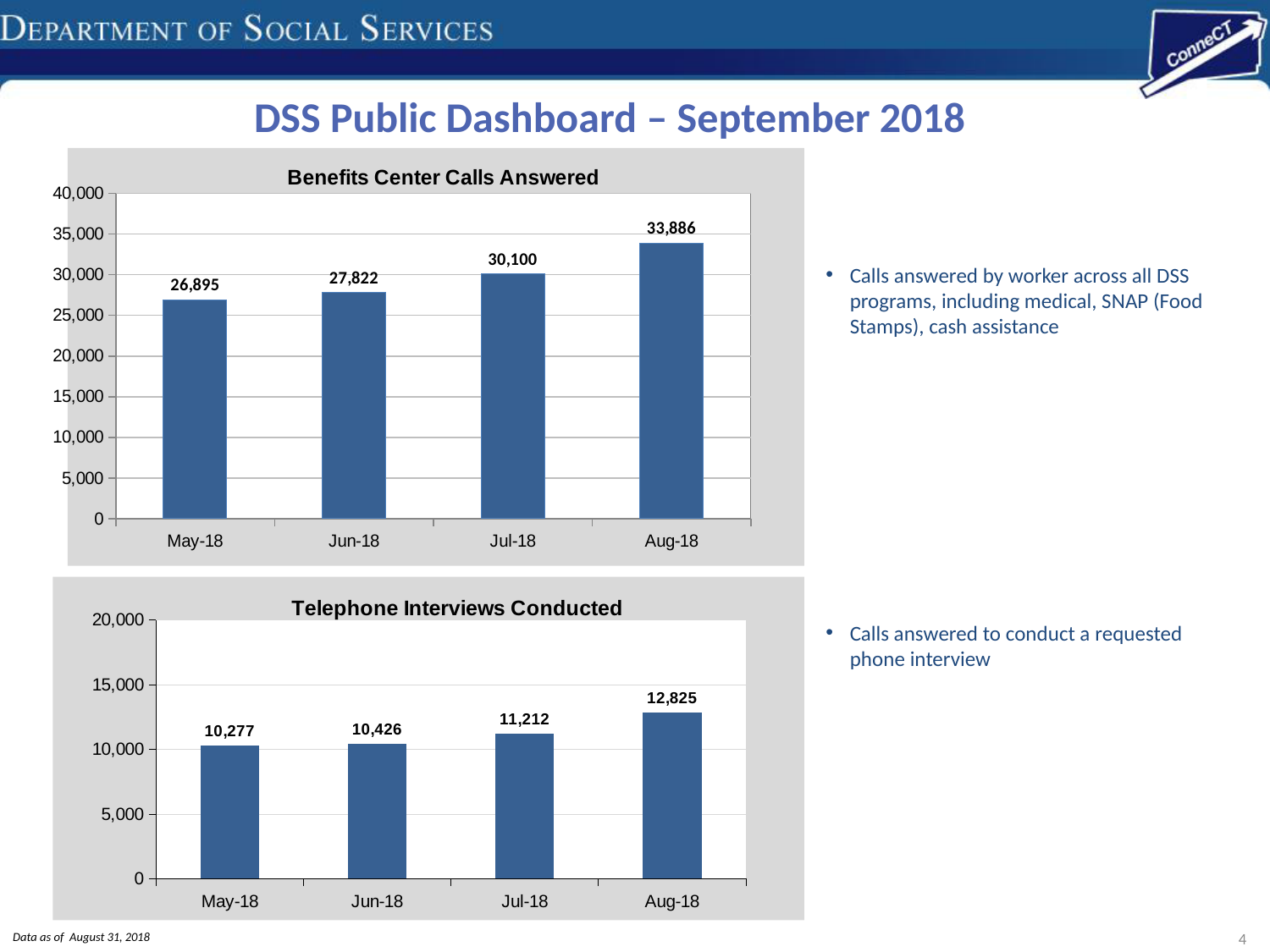
In the Telephone Interviews Conducted chart, is the value for Aug-18 greater or less than 15,000? less In the Benefits Center Calls Answered chart, do the values rise or fall from May-18 to Aug-18? rise In the Telephone Interviews Conducted chart, what is the value for Jun-18? 10,426 What kind of chart is the Telephone Interviews Conducted chart? bar chart In the Telephone Interviews Conducted chart, what is the value for Aug-18? 12,825 In the Benefits Center Calls Answered chart, what is the difference between the Aug-18 and May-18 values? 6,991 In the Telephone Interviews Conducted chart, what is the difference between the Jul-18 and Jun-18 values? 786 In the Benefits Center Calls Answered chart, which month has the highest value? Aug-18 In the Telephone Interviews Conducted chart, which month has the lowest value? May-18 In the Benefits Center Calls Answered chart, how many months are plotted? 4 In the Benefits Center Calls Answered chart, which month has the lowest value? May-18 In the Benefits Center Calls Answered chart, what is the value for Jul-18? 30,100